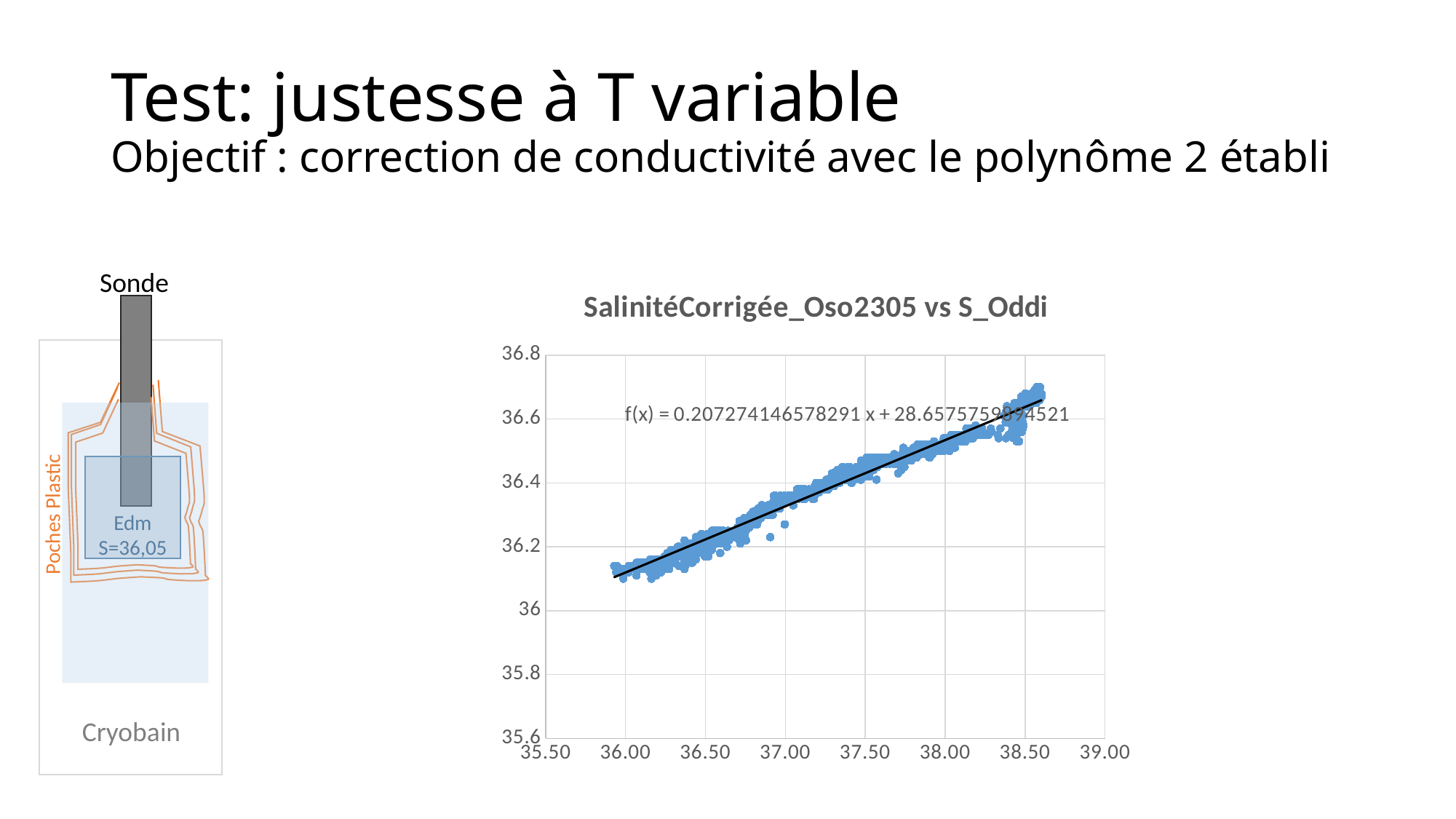
Which has the larger y value: the points near x = 36.50 or the points near x = 38.00? the points near x = 38.00 What is the maximum value shown on the y-axis? 36.8 Is the y value of the points at x = 36.00 greater or less than 36.2? less Is the y value of the points at x = 38.00 greater or less than 36.4? greater Is the y value of the points at x = 37.00 greater or less than 36.4? less What kind of chart is shown on the slide? scatter chart Do the plotted values rise or fall as the x-axis value increases? rise What is the title of the chart? SalinitéCorrigée_Oso2305 vs S_Oddi What is the slope (coefficient of x) in the trendline equation shown on the chart? 0.207274146578291